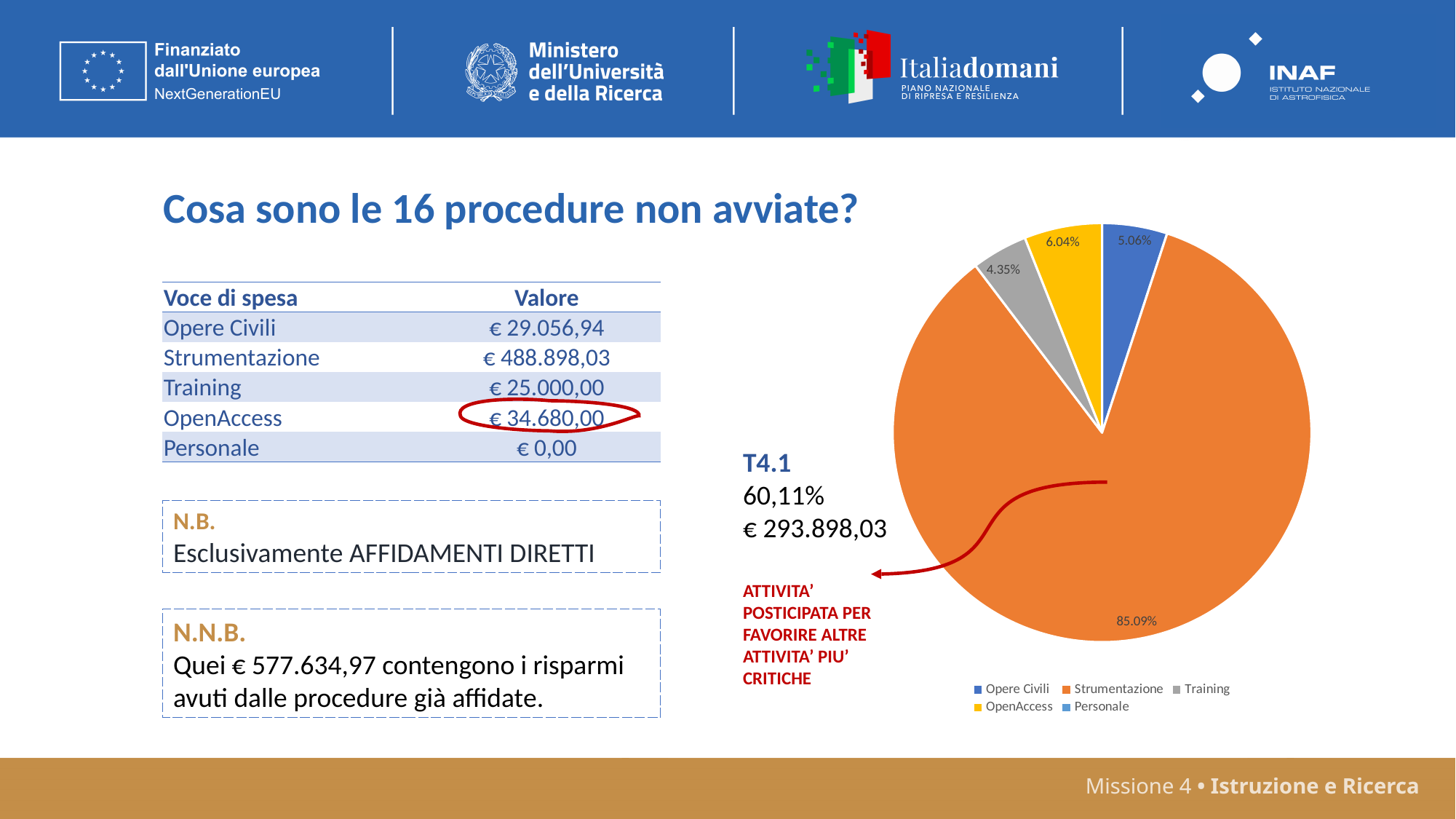
What share of the pie chart does Strumentazione have? 85.09% What kind of chart is shown on the slide? pie chart Which legend entry of the pie chart is shown in yellow? OpenAccess Which labelled slice in the pie chart is the smallest? Training What is the difference in percentage points between the Strumentazione slice and the OpenAccess slice in the pie chart? 79.05 In the pie chart, which is larger: the OpenAccess slice or the Opere Civili slice? OpenAccess What share of the pie chart does Opere Civili have? 5.06% Which category has the largest slice in the pie chart? Strumentazione What share of the pie chart does Training have? 4.35% How many entries does the legend of the pie chart list? 5 What share of the pie chart does OpenAccess have? 6.04% What colour is the Strumentazione slice in the pie chart? orange